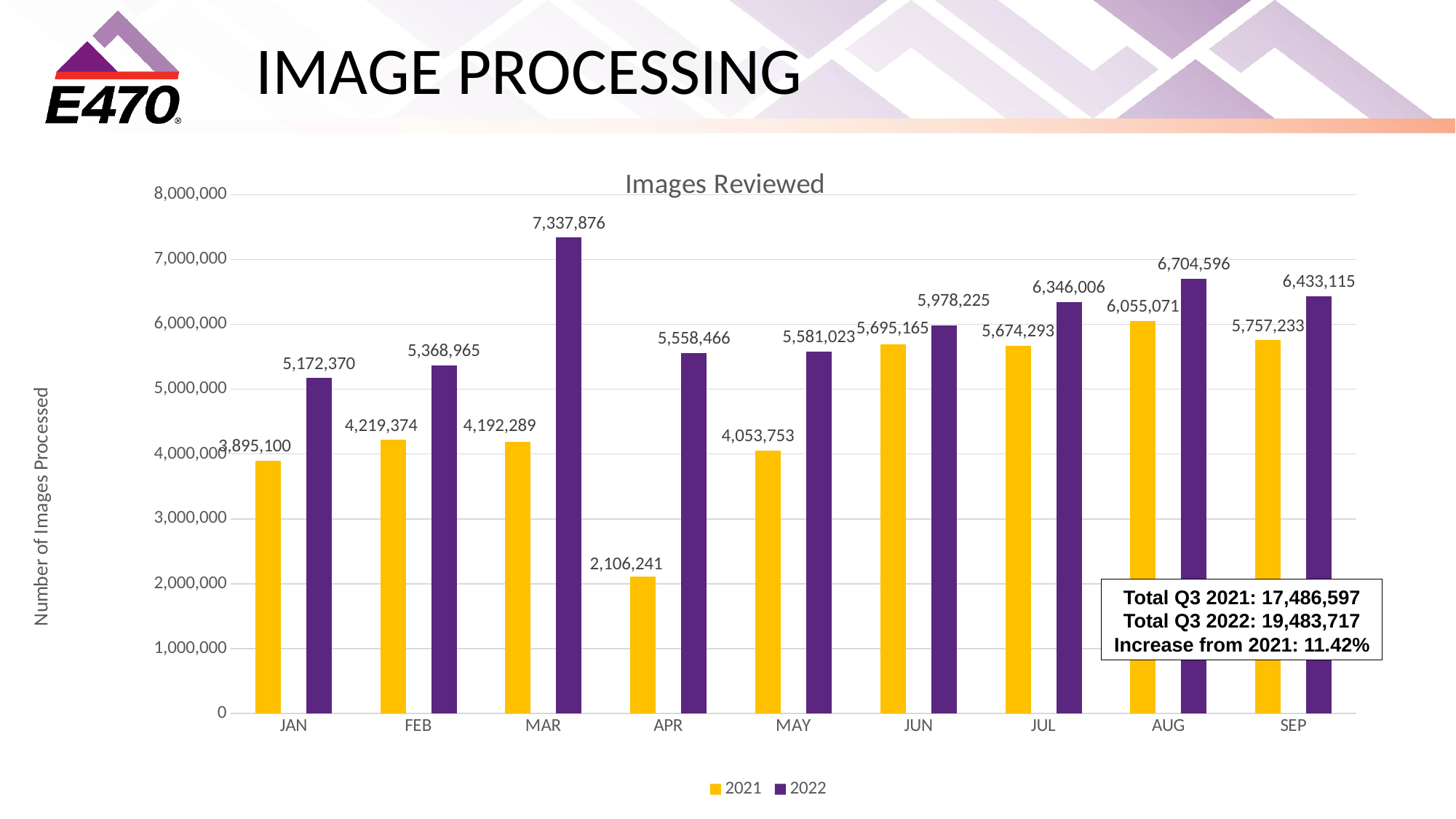
What is the value for 2021 in APR? 2,106,241 What is the value for 2022 in MAR? 7,337,876 What is the value for 2021 in AUG? 6,055,071 Which month has the lowest value for 2021? APR Which is larger in JUN, the 2021 value or the 2022 value? 2022 What is the value for 2022 in SEP? 6,433,115 What kind of chart is shown on the slide? Bar chart How many series does the legend list? 2 What is the title of the chart? Images Reviewed How many months are shown on the x axis? 9 What is the difference between the 2022 and 2021 values in MAR? 3,145,587 Which month has the highest value for 2022? MAR